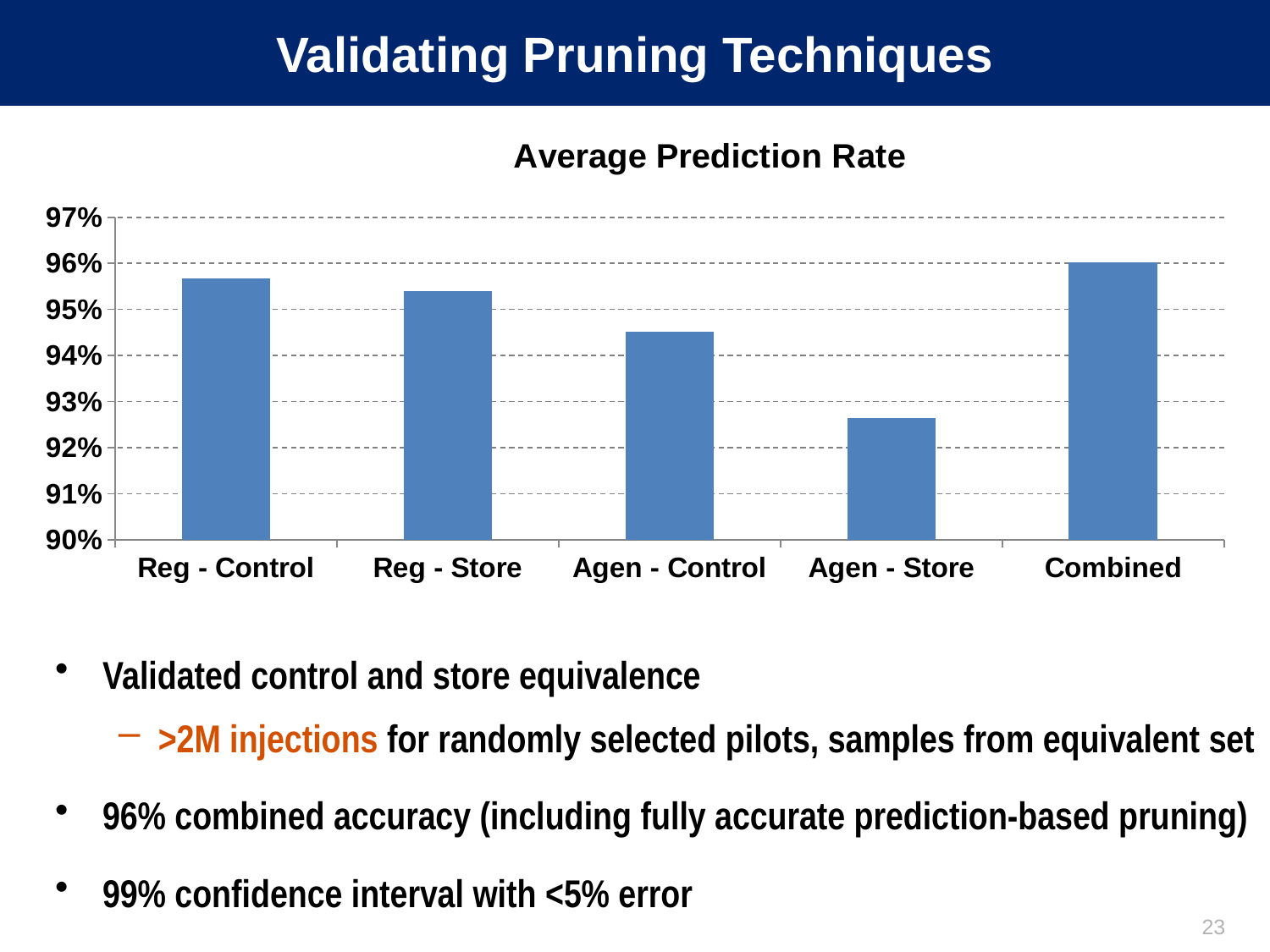
Is the value for Agen - Control greater or less than 94%? greater How many categories are shown on the x axis of the chart? 5 What is the average prediction rate for Combined? 96% Which category has the highest average prediction rate? Combined Which category has the lowest average prediction rate? Agen - Store What is the title of the chart? Average Prediction Rate Which is larger, the value for Reg - Control or the value for Agen - Control? Reg - Control What kind of chart is shown on the slide? bar chart Do the values rise or fall along the x axis from Reg - Control to Agen - Store? fall Is the value for Agen - Store greater or less than 93%? less Which is larger, the value for Agen - Control or the value for Agen - Store? Agen - Control Is the value for Reg - Control greater or less than 95%? greater